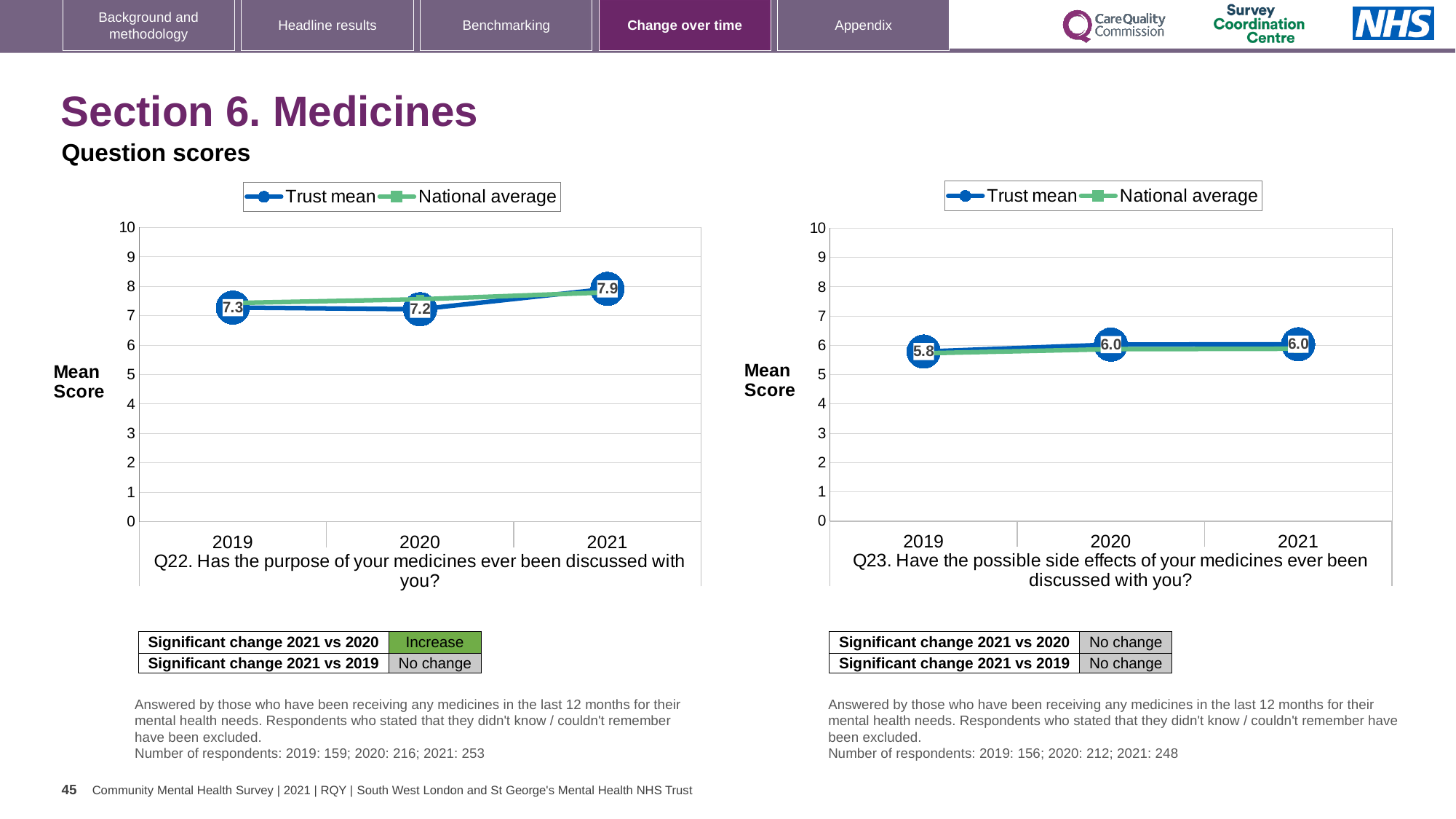
How many series does the legend of the Q22 chart on the left list? 2 In the Q22 chart on the left, what is the Trust mean score for 2019? 7.3 In the Q22 chart on the left, which year has the highest Trust mean score? 2021 In the Q23 chart on the right, is the Trust mean score for 2019 greater or less than 7? less In the Q22 chart on the left, which year has the lowest Trust mean score? 2020 In the Q22 chart on the left, does the Trust mean rise or fall from 2020 to 2021? Rise What kind of chart is the Q23 chart on the right? Line chart In the Q23 chart on the right, what is the Trust mean score for 2020? 6.0 In the Q23 chart on the right, which year has the lowest Trust mean score? 2019 In the Q22 chart on the left, what is the Trust mean score for 2021? 7.9 In the Q23 chart on the right, what is the Trust mean score for 2019? 5.8 In the Q22 chart on the left, what is the difference between the Trust mean scores for 2021 and 2020? 0.7